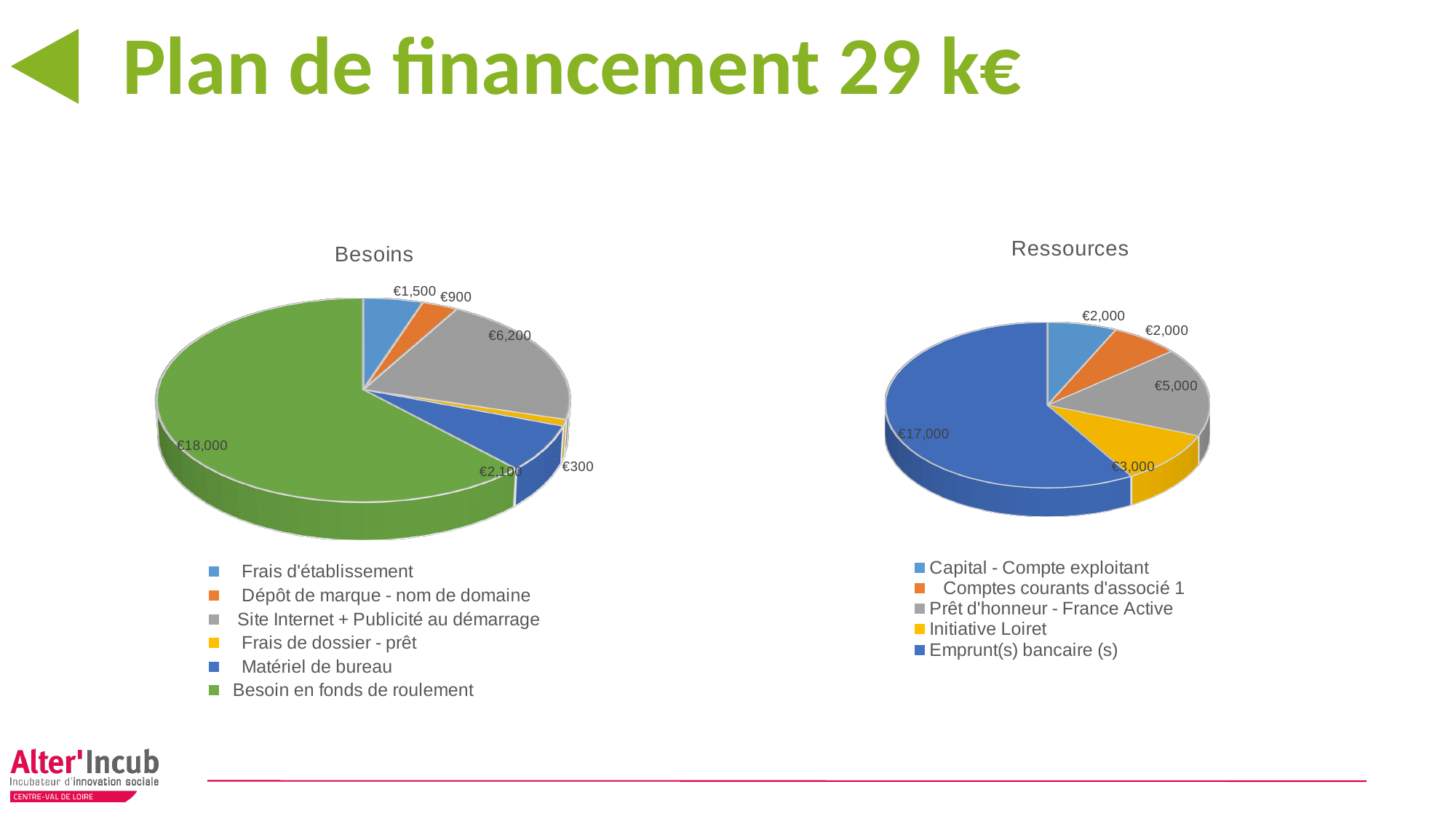
How many categories does the Ressources chart show? 5 In the Ressources chart, what is the total of all slices? €29,000 What type of chart is the Ressources chart? Pie chart How many categories does the Besoins chart show? 6 In the Besoins chart, what is the value for Besoin en fonds de roulement? €18,000 In the Ressources chart, which is larger: Prêt d'honneur - France Active or Initiative Loiret? Prêt d'honneur - France Active In the Ressources chart, what is the value for Prêt d'honneur - France Active? €5,000 In the Besoins chart, what is the difference between Matériel de bureau and Frais d'établissement? €600 In the Ressources chart, which category has the largest value? Emprunt(s) bancaire (s) In the Besoins chart, which category has the smallest value? Frais de dossier - prêt In the Besoins chart, what is the value for Site Internet + Publicité au démarrage? €6,200 In the Ressources chart, what is the value for Initiative Loiret? €3,000